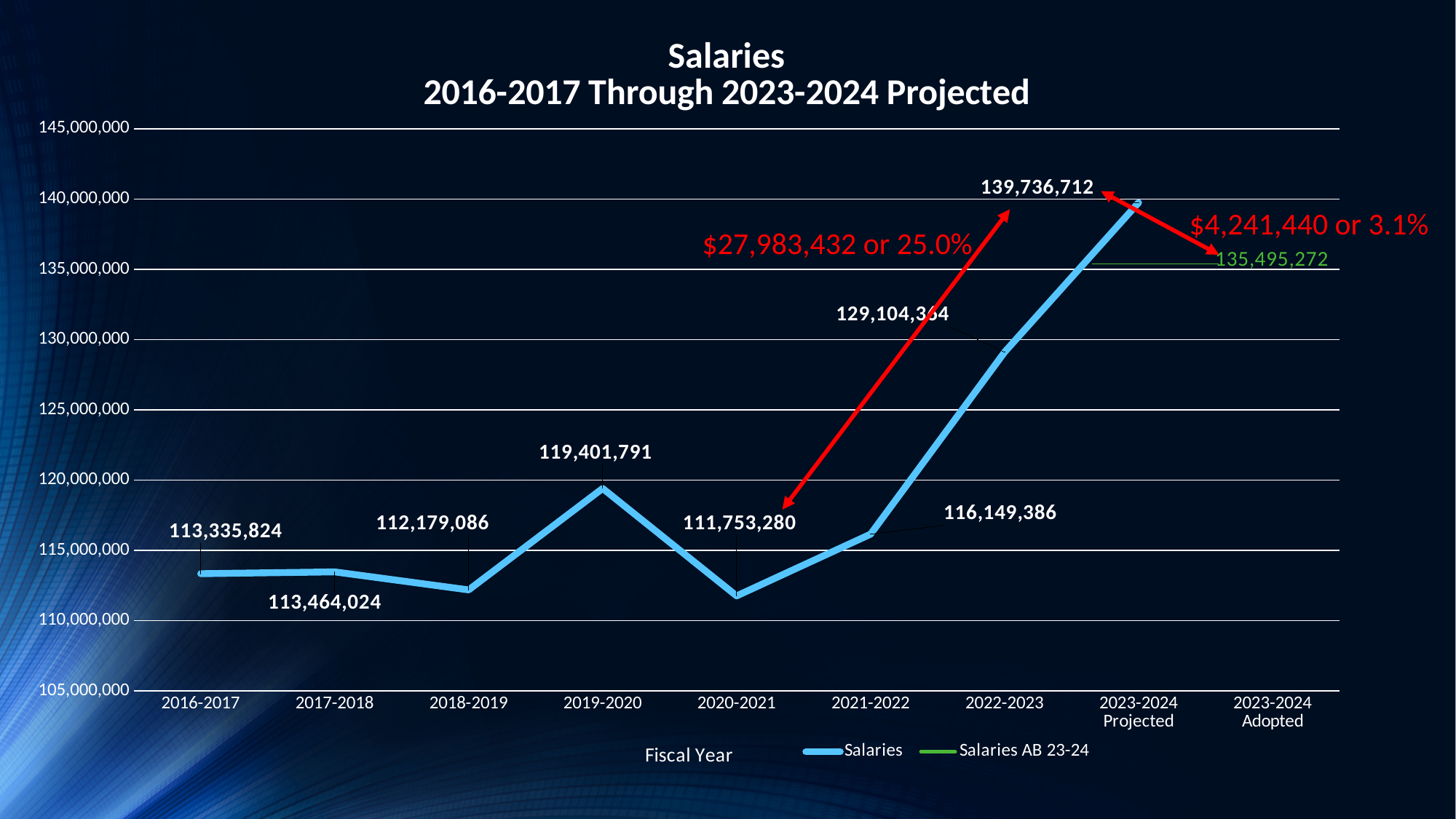
Which fiscal year has the lowest Salaries value? 2020-2021 Is the Salaries value for 2022-2023 greater or less than 125,000,000? greater What is the Salaries value for 2019-2020? 119,401,791 Which fiscal year has the highest Salaries value? 2023-2024 Projected What is the Salaries value for 2020-2021? 111,753,280 What is the difference between the Salaries values for 2017-2018 and 2016-2017? 128,200 Which is larger, the Salaries value for 2019-2020 or for 2021-2022? 2019-2020 What kind of chart is shown on the slide? Line chart How many series does the legend list? 2 What is the difference between the 2023-2024 Projected value and the 2023-2024 Adopted value? 4,241,440 What is the value shown for 2023-2024 Adopted? 135,495,272 Do the Salaries values rise or fall from 2020-2021 to 2023-2024 Projected? Rise